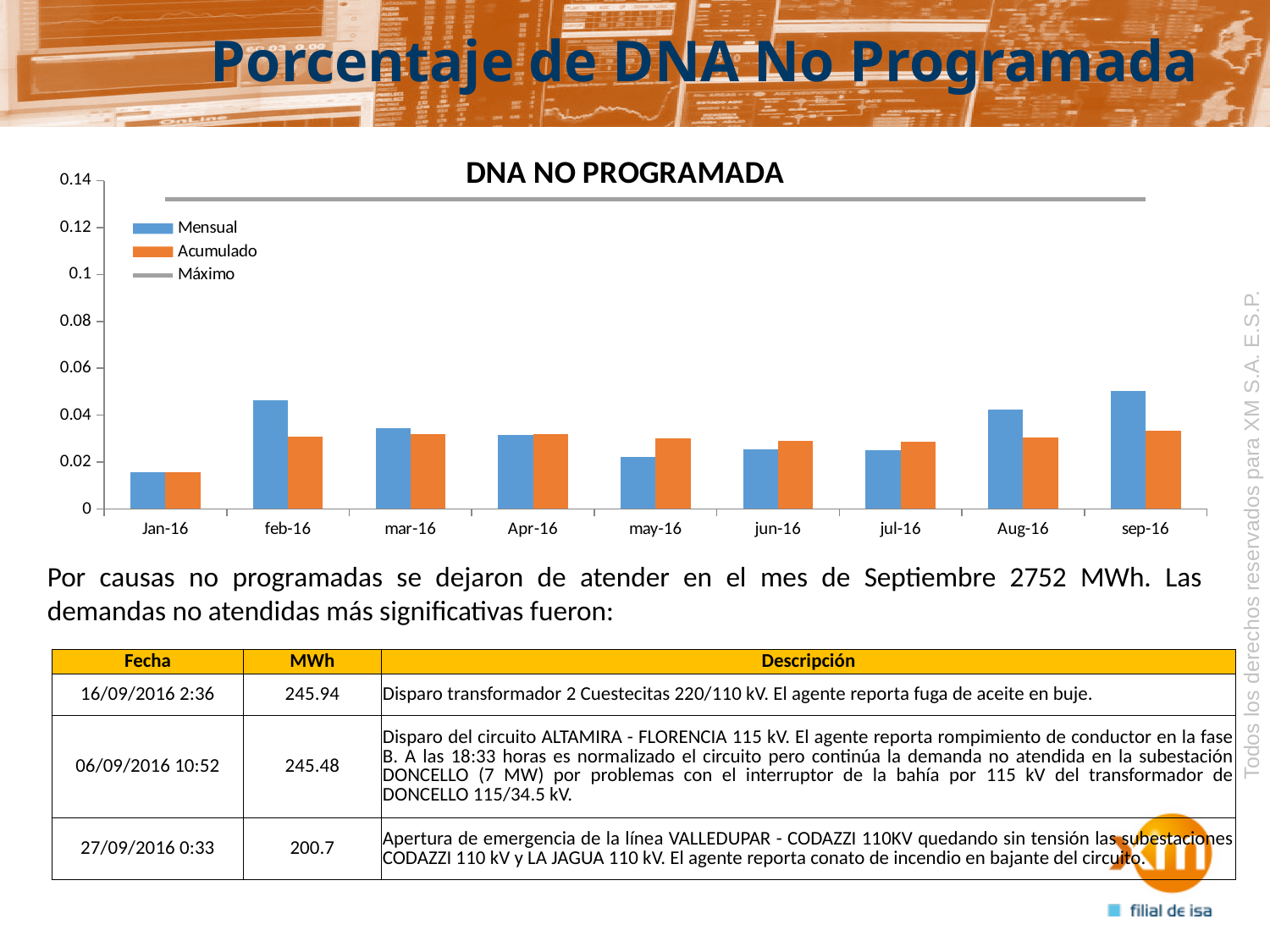
How many series does the chart legend list? 3 Is the Mensual value for sep-16 greater or less than 0.04? greater For feb-16, which is larger: the Mensual value or the Acumulado value? Mensual Which colour represents the Acumulado series in the chart? orange Is the Mensual value for feb-16 greater or less than 0.04? greater Is the Mensual value for Jan-16 greater or less than 0.02? less How many months are shown on the x axis of the chart? 9 Which month has the highest Mensual value? sep-16 Which month has the lowest Mensual value? Jan-16 What is the title of the chart? DNA NO PROGRAMADA What kind of chart is shown on the slide? bar chart